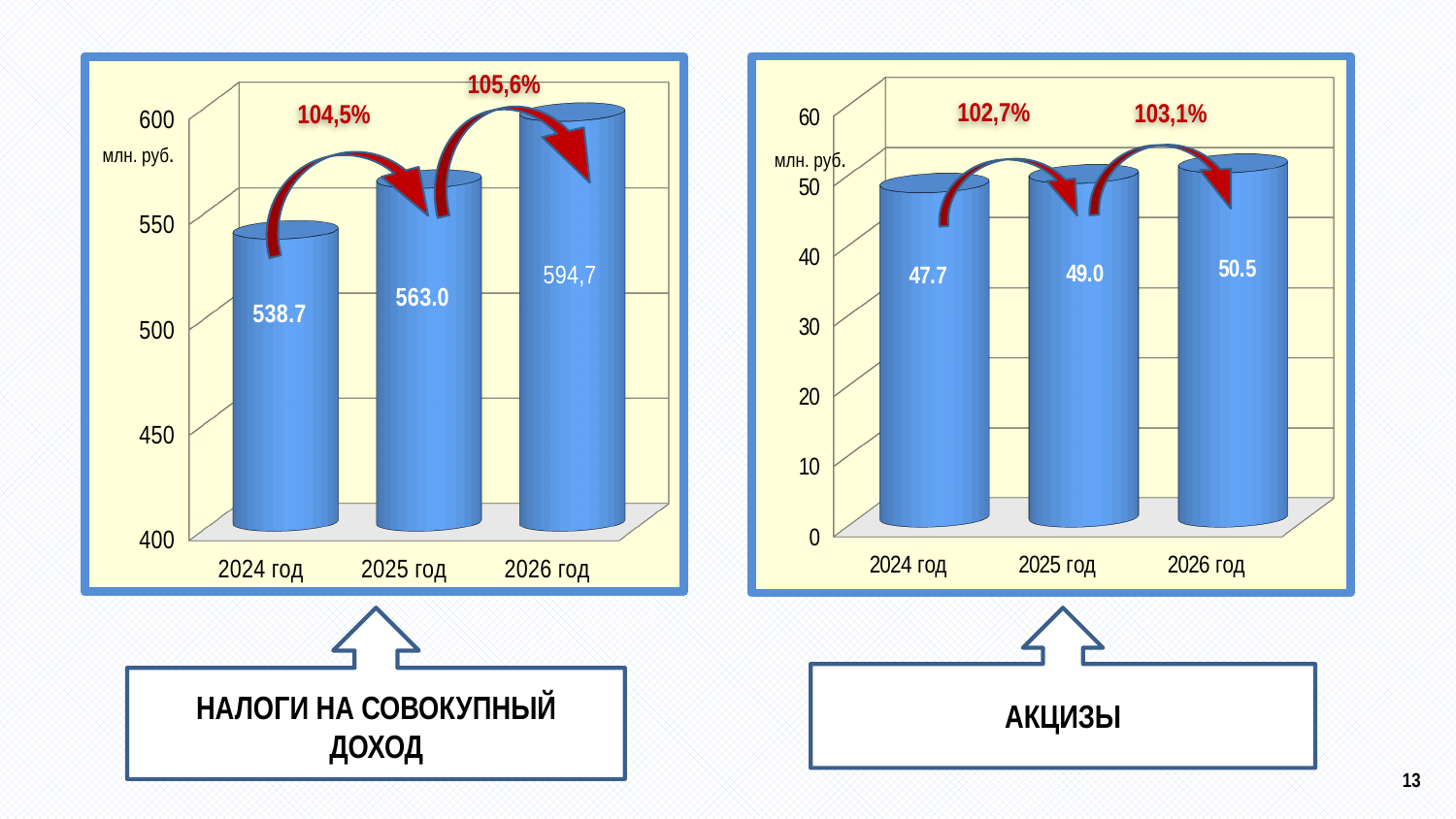
In the left chart (НАЛОГИ НА СОВОКУПНЫЙ ДОХОД), what is the value for 2026 год? 594,7 In the left chart (НАЛОГИ НА СОВОКУПНЫЙ ДОХОД), what is the value for 2025 год? 563.0 In the right chart (АКЦИЗЫ), which year has the highest value? 2026 год What kind of chart is the left chart (НАЛОГИ НА СОВОКУПНЫЙ ДОХОД)? bar chart In the left chart (НАЛОГИ НА СОВОКУПНЫЙ ДОХОД), what is the difference between the values for 2025 год and 2024 год? 24.3 How many years are shown in the right chart (АКЦИЗЫ)? 3 In the left chart (НАЛОГИ НА СОВОКУПНЫЙ ДОХОД), which year has the lowest value? 2024 год In the right chart (АКЦИЗЫ), what is the difference between the values for 2026 год and 2025 год? 1.5 In the right chart (АКЦИЗЫ), what is the value for 2026 год? 50.5 In the right chart (АКЦИЗЫ), what is the value for 2024 год? 47.7 In the right chart (АКЦИЗЫ), which is larger: the value for 2024 год or 2025 год? 2025 год In the left chart (НАЛОГИ НА СОВОКУПНЫЙ ДОХОД), do the values rise or fall from 2024 год to 2026 год? rise